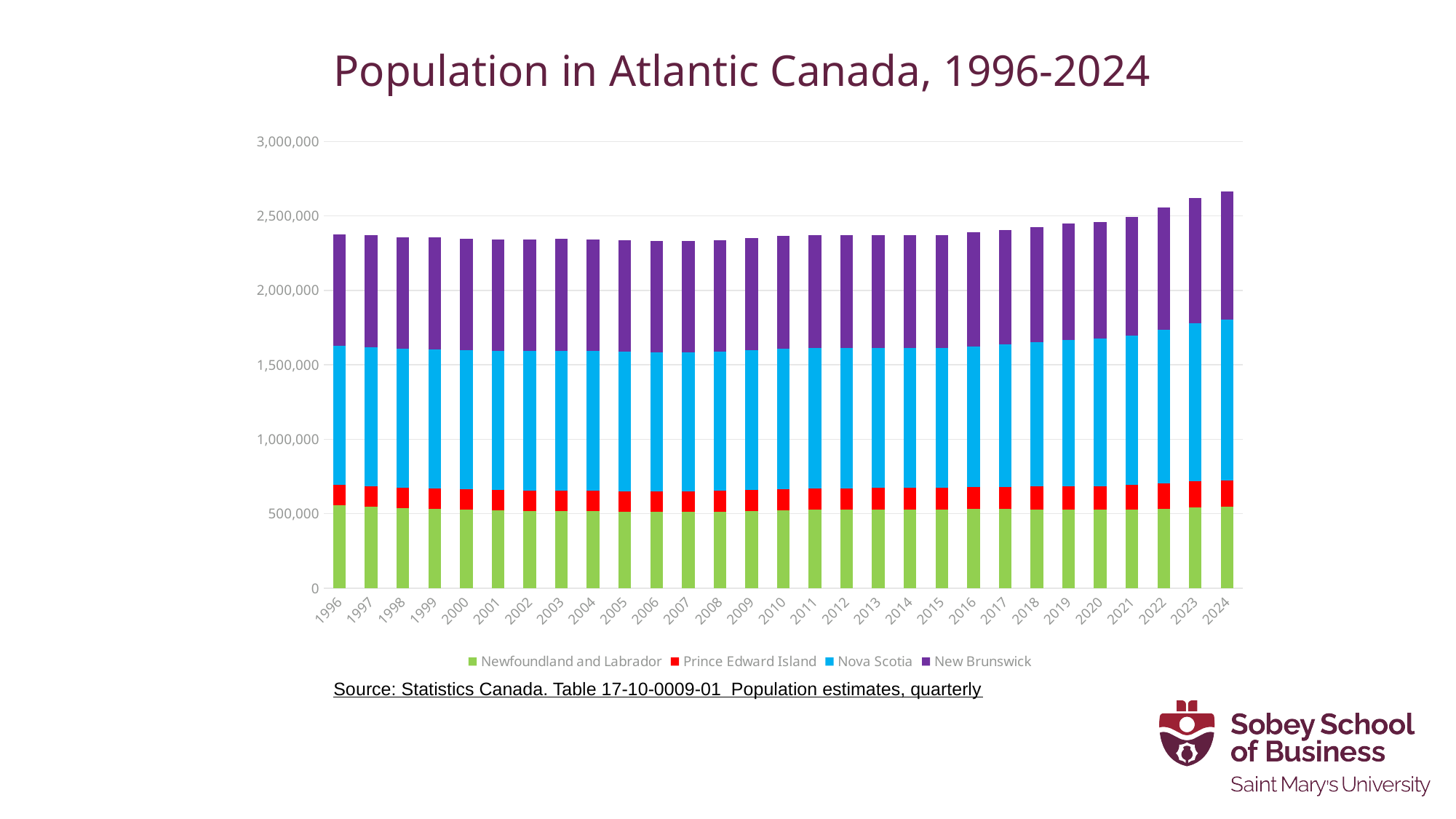
Do the total stacked bars rise or fall from 2017 to 2024? Rise What kind of chart is shown on the slide? Stacked bar chart Is the total population for 1996 greater or less than 2,000,000? greater Which series is shown in blue in the legend? Nova Scotia Which is larger, the total stacked bar for 2024 or for 1996? 2024 Is the total population for 2024 greater or less than 2,500,000? greater Which year has the highest total stacked bar? 2024 How many years (bars) are plotted on the x axis? 29 Is the total population for 2006 greater or less than 2,500,000? less How many series does the legend list? 4 What is the title of the chart? Population in Atlantic Canada, 1996-2024 Which series forms the bottom segment of each stacked bar? Newfoundland and Labrador